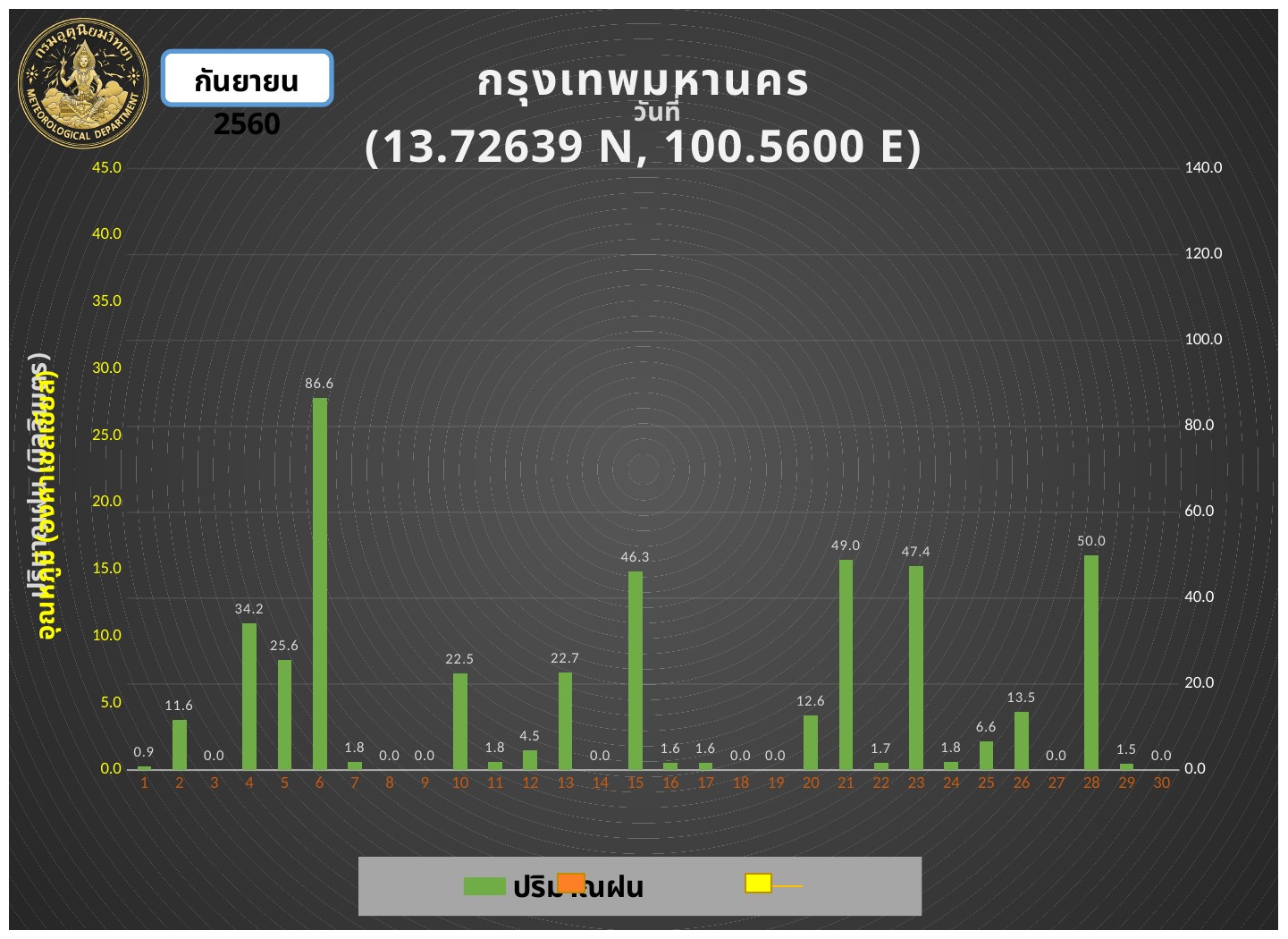
Which day has the highest rainfall value? 6 What is the difference between the rainfall values for day 4 and day 5? 8.6 What kind of chart is shown on the slide? bar chart Which has a larger rainfall value, day 21 or day 23? day 21 What is the rainfall value for day 28? 50.0 What is the difference between the rainfall values for day 6 and day 28? 36.6 How many days are shown on the x axis of the chart? 30 What coordinates are given in the chart title? 13.72639 N, 100.5600 E What is the rainfall value for day 6? 86.6 Which has a larger rainfall value, day 10 or day 26? day 10 What is the rainfall value for day 20? 12.6 What is the rainfall value for day 15? 46.3